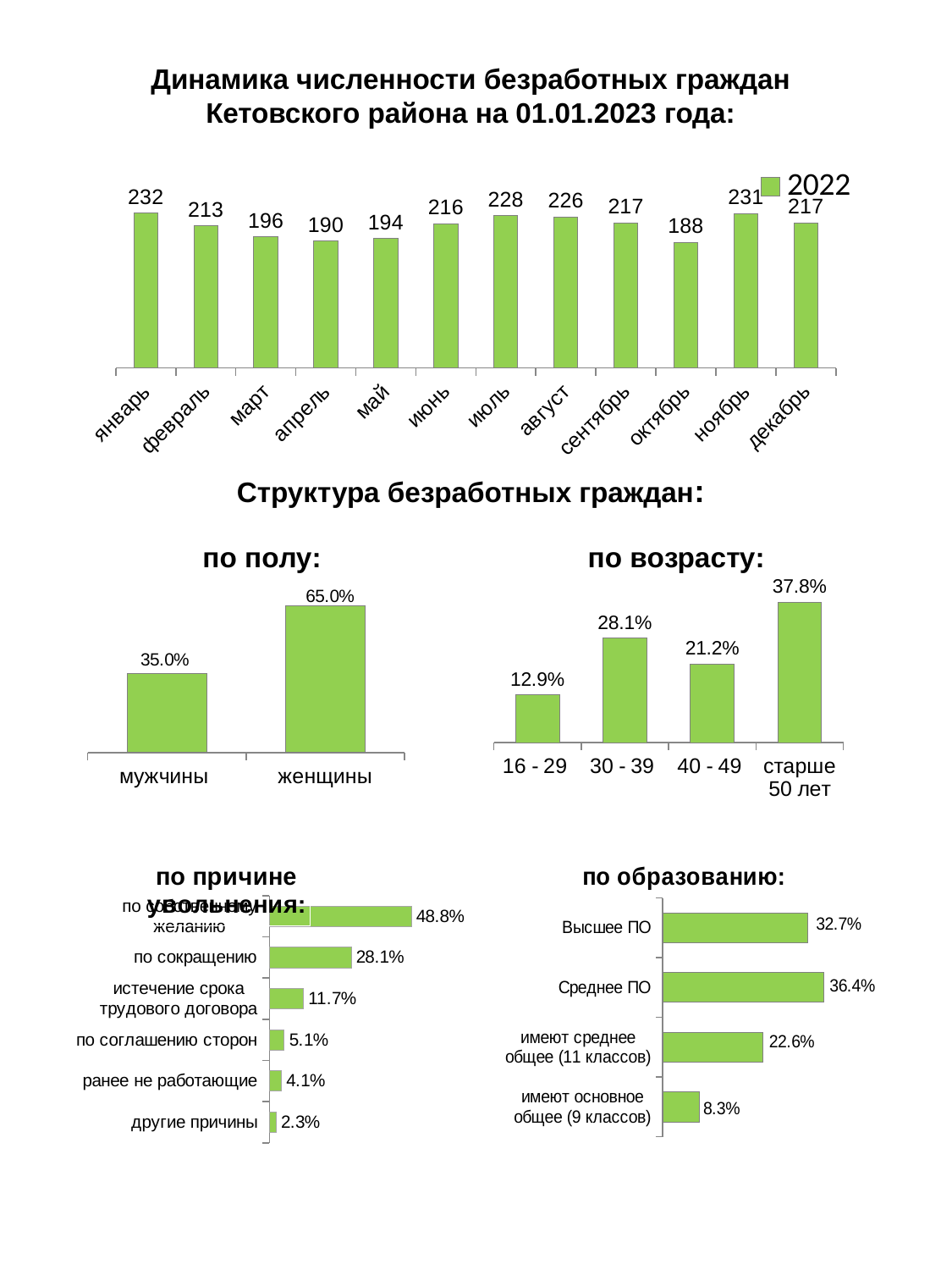
In the top chart 'Динамика численности безработных граждан', what is the difference between the values for июль and апрель? 38 In the top chart 'Динамика численности безработных граждан', which month has the lowest value? октябрь In the chart 'по возрасту', which is larger: the value for 30 - 39 or the value for 16 - 29? 30 - 39 In the chart 'по возрасту', what is the value for 40 - 49? 21.2% In the chart 'по возрасту', which age group has the highest value? старше 50 лет In the top chart 'Динамика численности безработных граждан', what year does the legend show? 2022 In the chart 'по причине увольнения', what is the value for по сокращению? 28.1% In the chart 'по образованию', which category has the highest value? Среднее ПО In the top chart 'Динамика численности безработных граждан', what is the value for январь? 232 In the top chart 'Динамика численности безработных граждан', how many months are plotted? 12 What kind of chart is 'по образованию'? bar chart In the chart 'по полу', what is the value for женщины? 65.0%